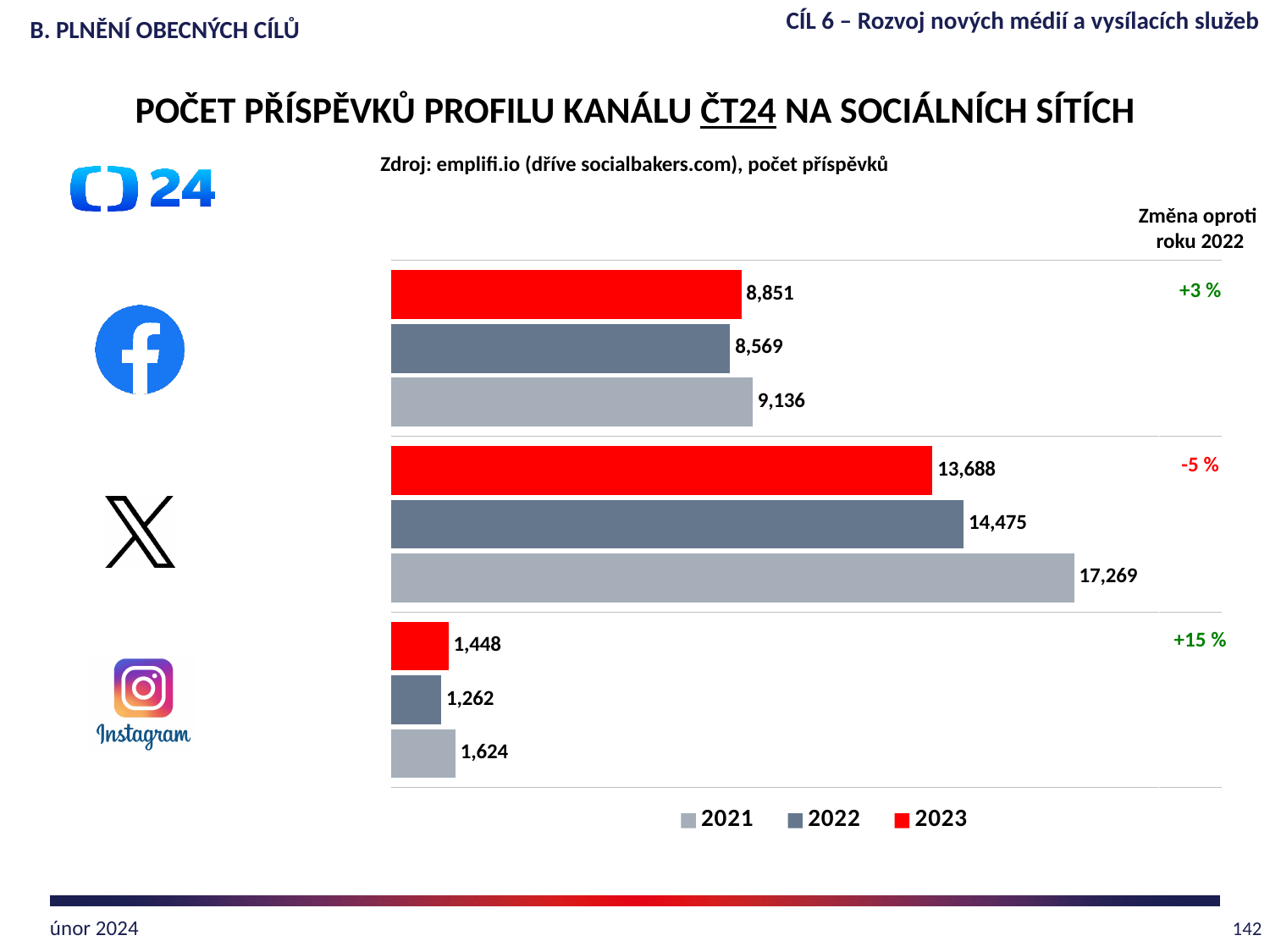
Which colour represents the 2023 series in the chart? red What is the number of posts on Instagram in 2021? 1,624 Which is larger: the number of posts on Facebook in 2022 or in 2021? 2021 What is the change compared to 2022 shown for Instagram? +15 % What is the difference between the number of posts on X in 2021 and in 2023? 3,581 Which social network has the lowest number of posts in 2021? Instagram How many social networks (categories) are shown in the chart? 3 Which social network has the highest number of posts in 2023? X What is the number of posts on Facebook in 2023? 8,851 What is the number of posts on X in 2022? 14,475 How many series does the legend list? 3 What kind of chart is shown on the slide? bar chart